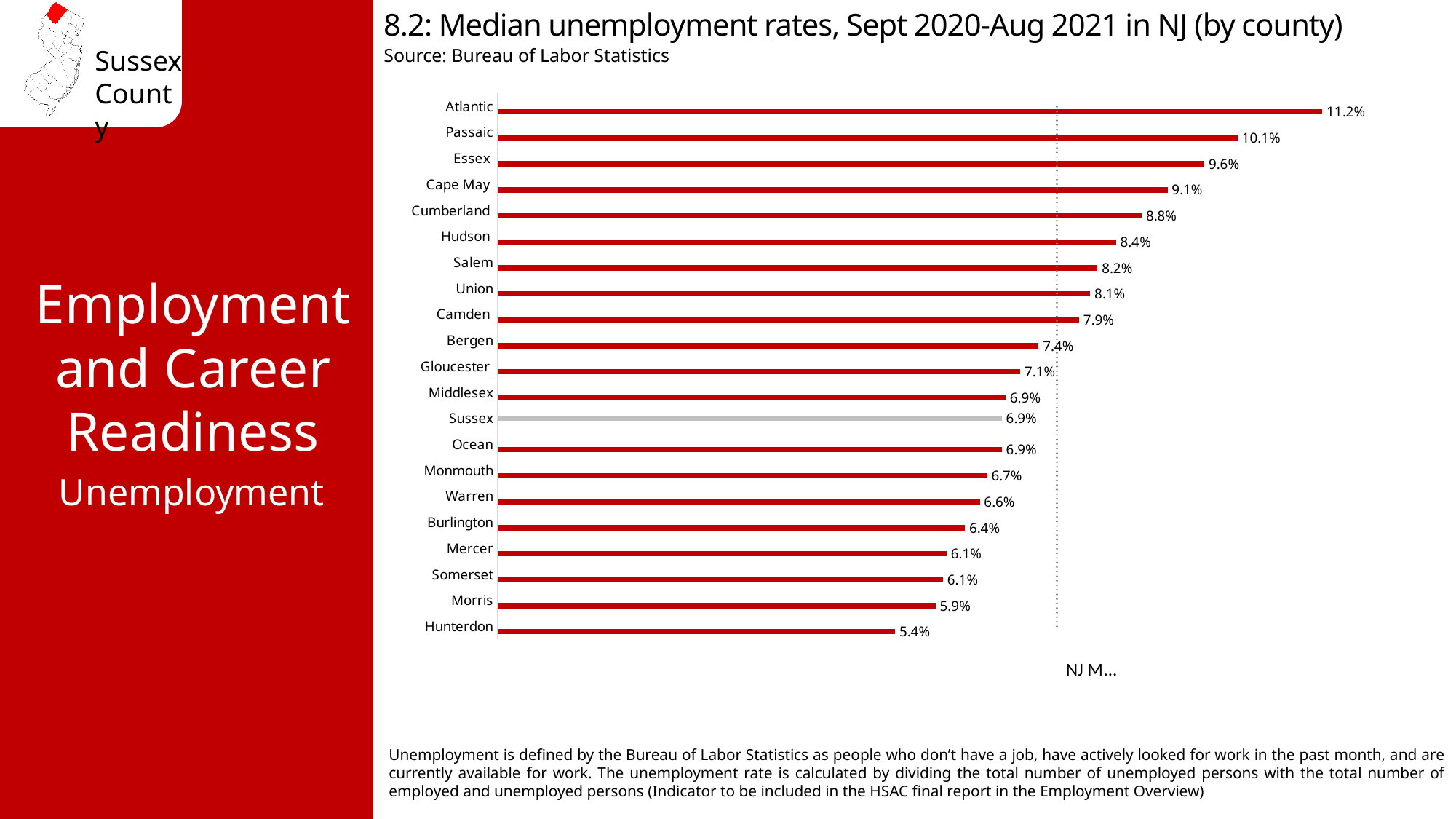
How many counties are shown in the chart? 21 What is the median unemployment rate for Hunterdon county? 5.4% What is the median unemployment rate for Hudson county? 8.4% Which county's bar is shown in grey rather than red? Sussex What is the difference between the median unemployment rates of Passaic and Essex counties? 0.5% Which county has a higher median unemployment rate, Cape May or Camden? Cape May What is the median unemployment rate for Atlantic county? 11.2% Which county has the lowest median unemployment rate? Hunterdon Which county has the highest median unemployment rate? Atlantic What is the median unemployment rate for Sussex county? 6.9% What type of chart is used to show the median unemployment rates? Bar chart What is the difference between the median unemployment rates of Atlantic and Hunterdon counties? 5.8%